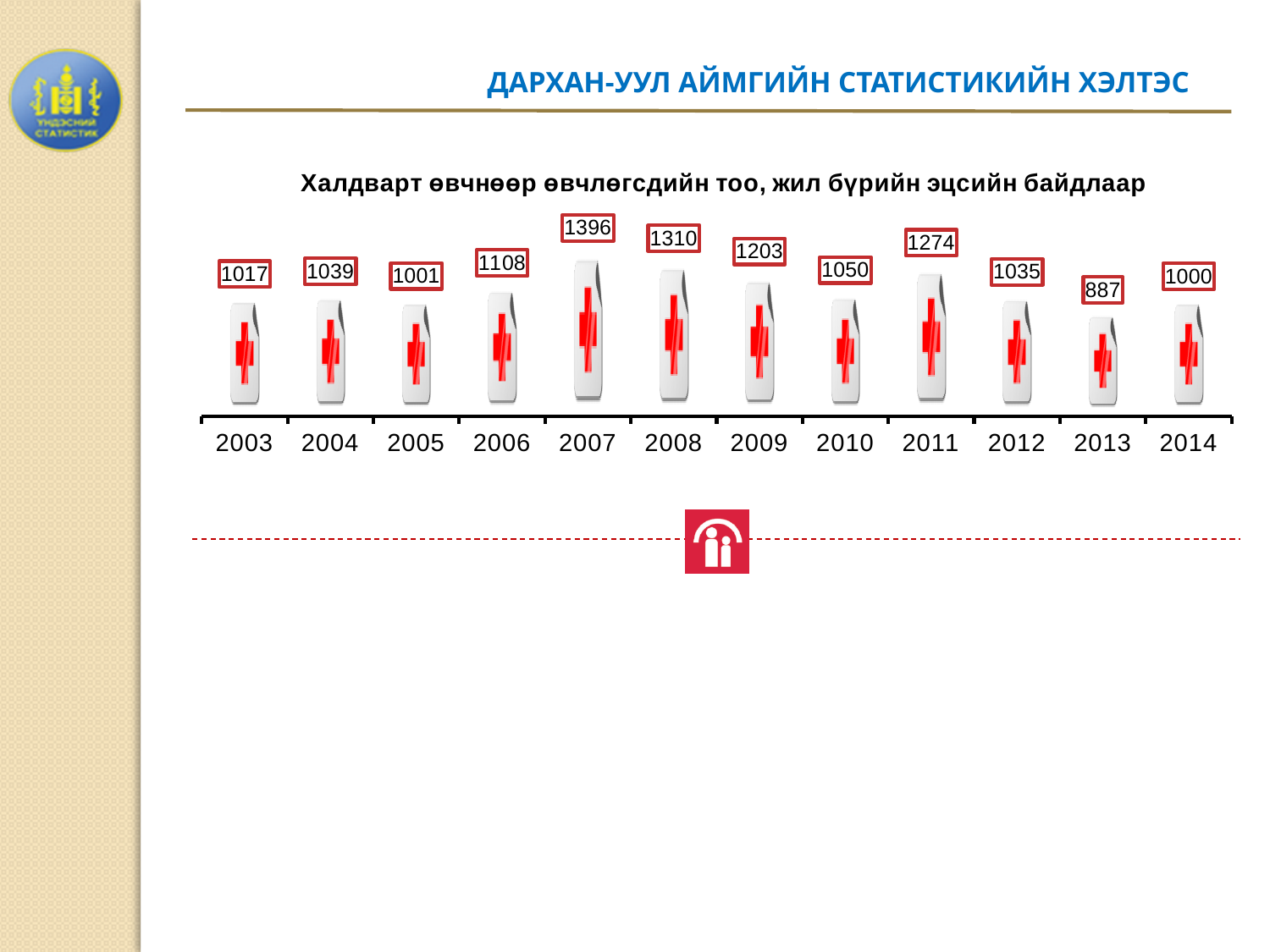
What is the value for 2011? 1274 What is the value for 2003? 1017 Which year has the lowest value? 2013 How many years are shown on the x axis? 12 What kind of chart is this? bar chart What is the value for 2007? 1396 What is the difference between the values for 2007 and 2008? 86 Which year has the highest value? 2007 Which is larger, the value for 2009 or the value for 2010? 2009 What is the difference between the values for 2014 and 2013? 113 What is the value for 2013? 887 Do the values rise or fall from 2011 to 2013? fall